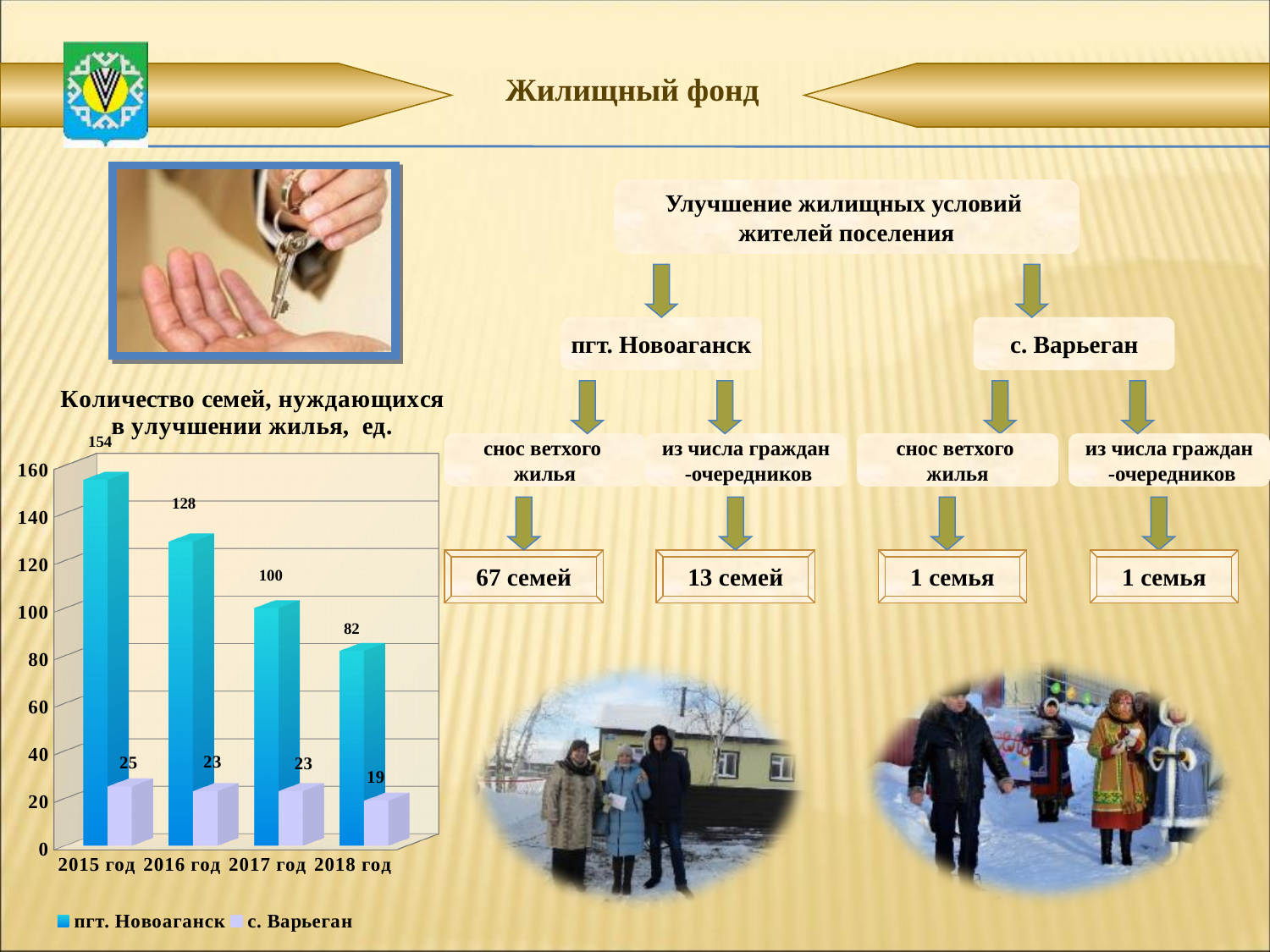
What kind of chart is shown on the slide? bar chart Do the values for пгт. Новоаганск rise or fall from 2015 год to 2018 год? fall Which year has the highest value for пгт. Новоаганск? 2015 год What is the value for пгт. Новоаганск in 2017 год? 100 Which is larger in 2016 год: пгт. Новоаганск or с. Варьеган? пгт. Новоаганск How many series does the chart legend list? 2 What is the difference between the пгт. Новоаганск and с. Варьеган values in 2018 год? 63 What is the value for пгт. Новоаганск in 2015 год? 154 Which year has the lowest value for с. Варьеган? 2018 год What is the difference between the пгт. Новоаганск values for 2015 год and 2016 год? 26 What is the value for с. Варьеган in 2018 год? 19 How many years are shown on the x axis of the chart? 4